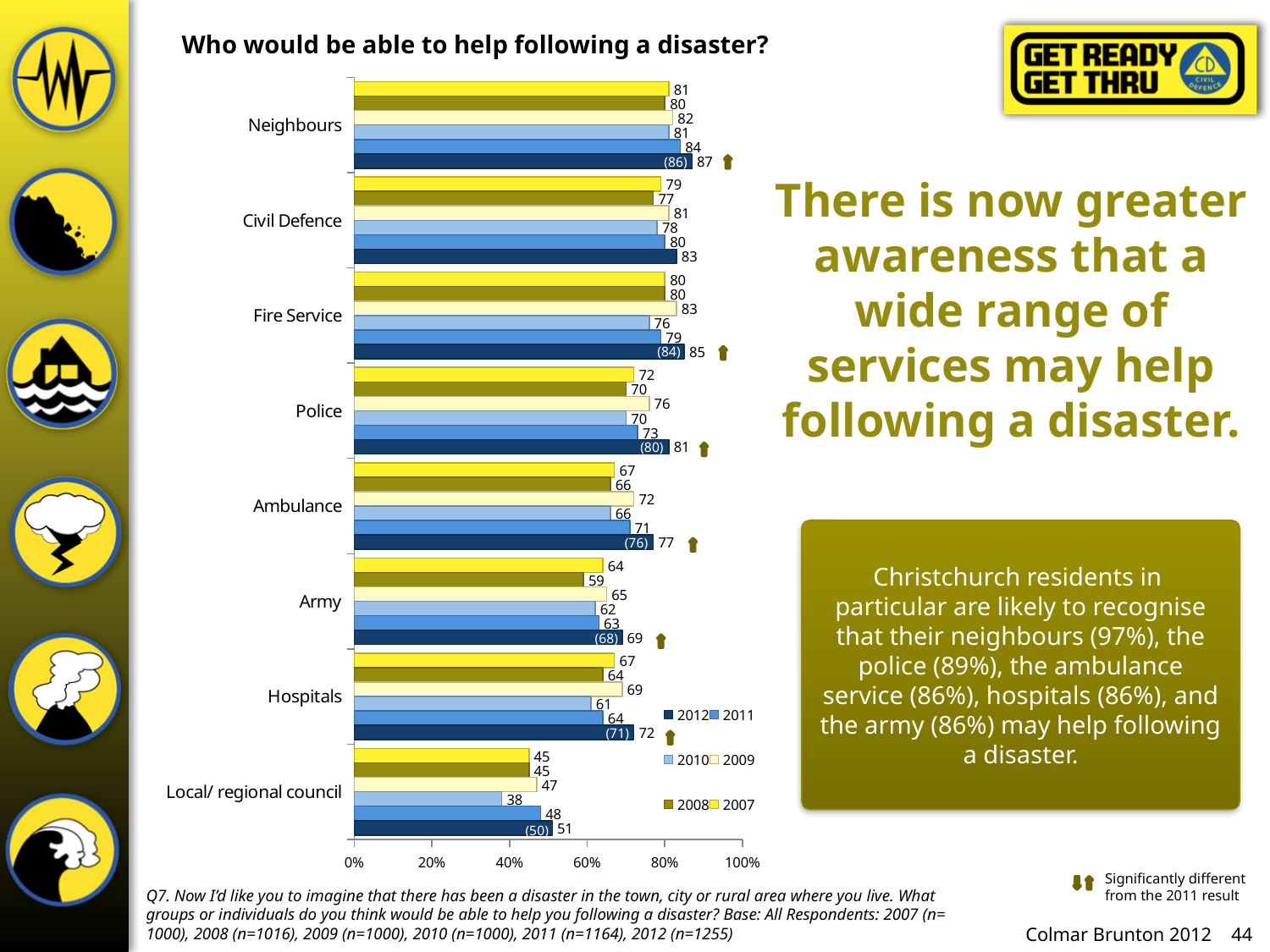
Which is larger, the 2012 value for Army or the 2012 value for Hospitals? Hospitals What is the 2010 value for Local/ regional council? 38 What is the 2012 value for Neighbours? 87 Which category has the lowest 2012 value? Local/ regional council What is the difference between the 2012 and 2011 values for Police? 8 What is the difference between the 2012 and 2007 values for Ambulance? 10 What kind of chart is shown on the slide? Bar chart Which category has the highest 2012 value? Neighbours How many categories are shown on the chart? 8 What is the title of the chart? Who would be able to help following a disaster? What is the 2009 value for Police? 76 How many series does the legend list? 6